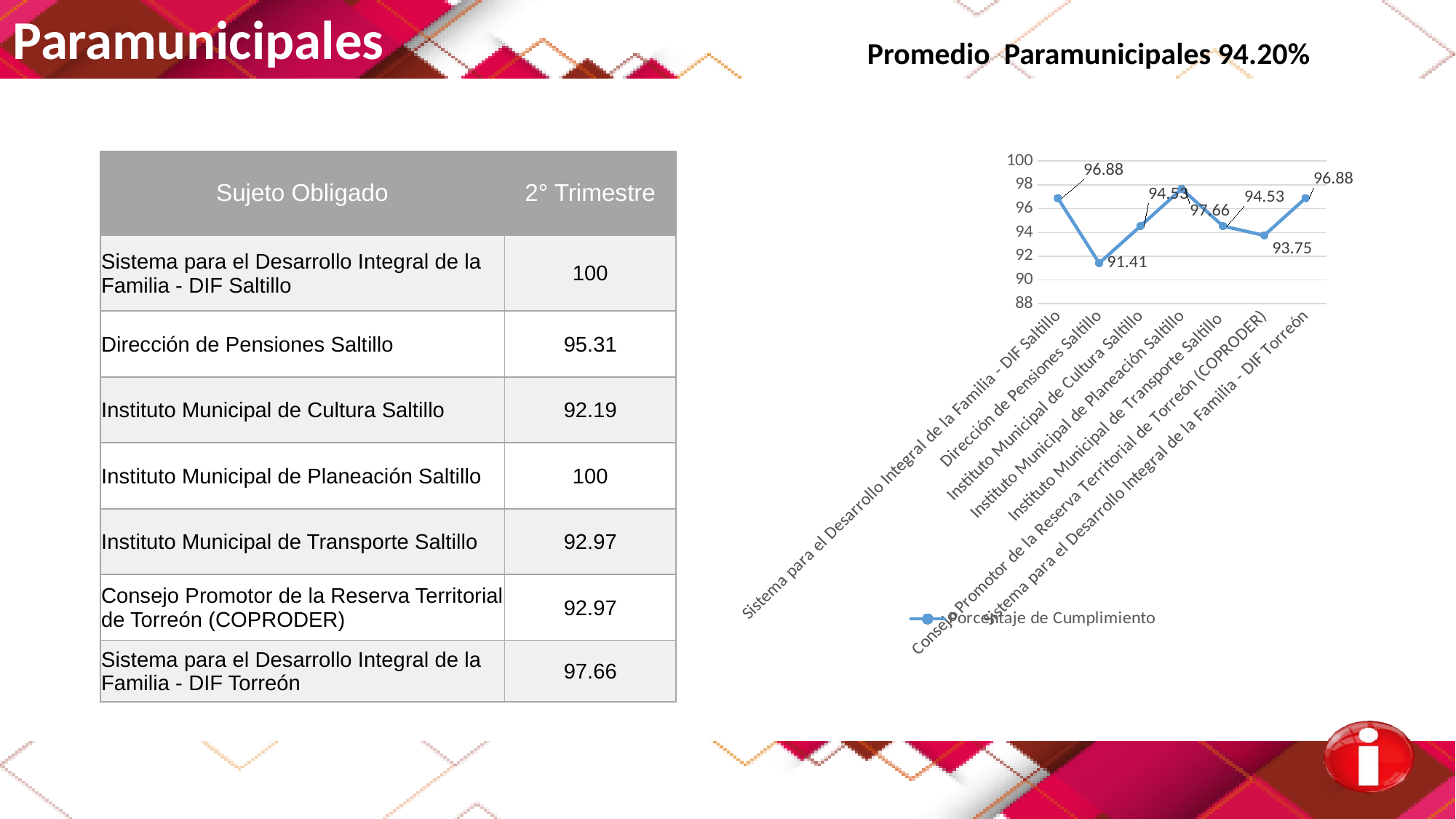
What is the name of the series shown in the line chart's legend? Porcentaje de Cumplimiento In the line chart, what is the value for Instituto Municipal de Cultura Saltillo? 94.53 How many data points are plotted in the line chart? 7 What type of chart is shown on the right of the slide? Line chart In the line chart, what is the value for Dirección de Pensiones Saltillo? 91.41 In the line chart, which category has the lowest value? Dirección de Pensiones Saltillo In the line chart, which is larger: the value for Dirección de Pensiones Saltillo or the value for Consejo Promotor de la Reserva Territorial de Torreón (COPRODER)? Consejo Promotor de la Reserva Territorial de Torreón (COPRODER) In the line chart, which category has the highest value? Instituto Municipal de Planeación Saltillo In the line chart, what is the difference between the highest value (97.66) and the lowest value (91.41)? 6.25 In the line chart, what is the value for Consejo Promotor de la Reserva Territorial de Torreón (COPRODER)? 93.75 In the line chart, what is the value for Instituto Municipal de Planeación Saltillo? 97.66 In the line chart, is the value for Dirección de Pensiones Saltillo greater or less than 92? less